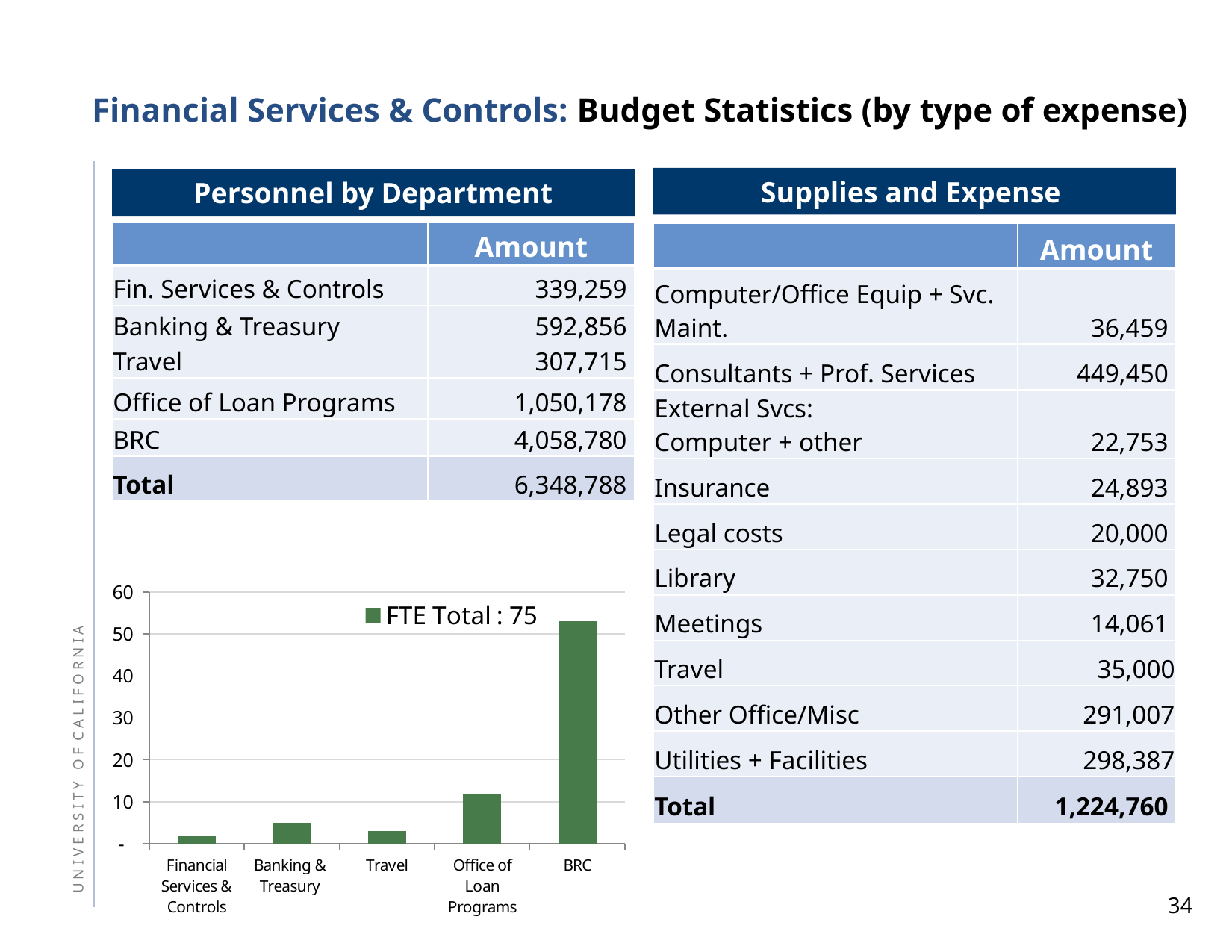
What kind of chart is shown on the slide? bar chart Is the value for Banking & Treasury greater or less than 10? less Is the value for Travel greater or less than 10? less Is the value for BRC greater or less than 50? greater Which department has the highest bar in the chart? BRC What is the legend entry shown on the bar chart? FTE Total : 75 Which is larger in the bar chart, the value for Office of Loan Programs or the value for Banking & Treasury? Office of Loan Programs What colour are the bars in the chart? green How many departments are shown on the x axis of the bar chart? 5 Which is larger in the bar chart, the value for BRC or the value for Office of Loan Programs? BRC How many series does the legend of the bar chart list? 1